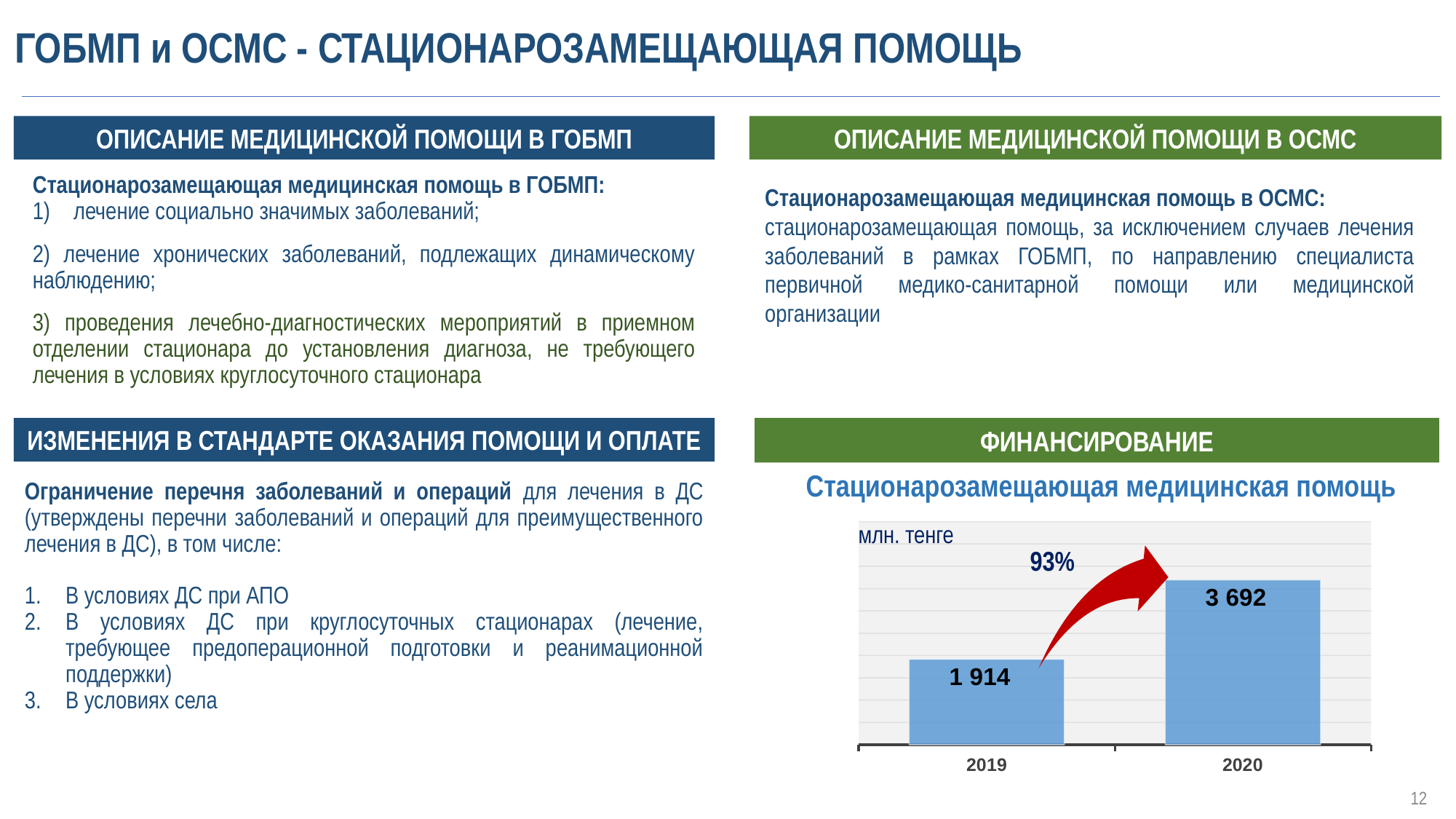
Which is larger in the chart, the value for 2019 or the value for 2020? 2020 What kind of chart is shown on the slide? bar chart What unit is indicated on the chart? млн. тенге What is the difference between the 2020 and 2019 values in the chart? 1 778 What is the title of the chart? Стационарозамещающая медицинская помощь What is the value for 2020 in the chart? 3 692 What percentage growth is annotated on the chart between 2019 and 2020? 93% Which year has the highest value in the chart? 2020 What is the value for 2019 in the chart? 1 914 Do the values in the chart rise or fall from 2019 to 2020? rise How many bars are shown in the chart? 2 Which year has the lowest value in the chart? 2019